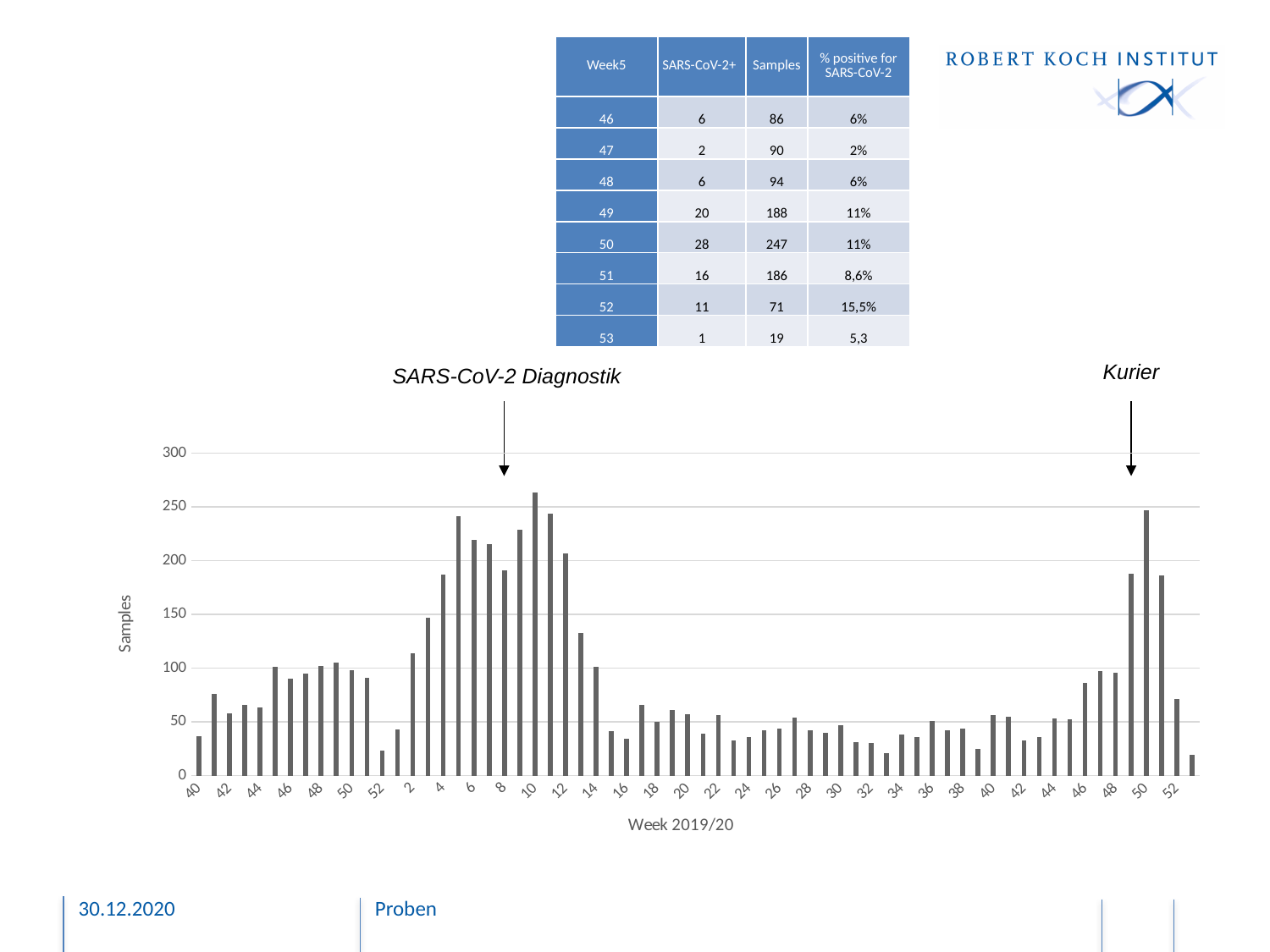
Which week has the highest bar in the chart? Week 10 Is the value for week 2 greater or less than 100? greater Is the value for week 6 greater or less than 200? greater Is the value for week 34 greater or less than 50? less What is the title of the vertical axis of the chart? Samples What kind of chart is shown on the slide? bar chart What is the title of the horizontal axis of the chart? Week 2019/20 Do the values rise or fall from week 12 to week 16? fall Which is larger, the value for week 10 or the value for week 30? Week 10